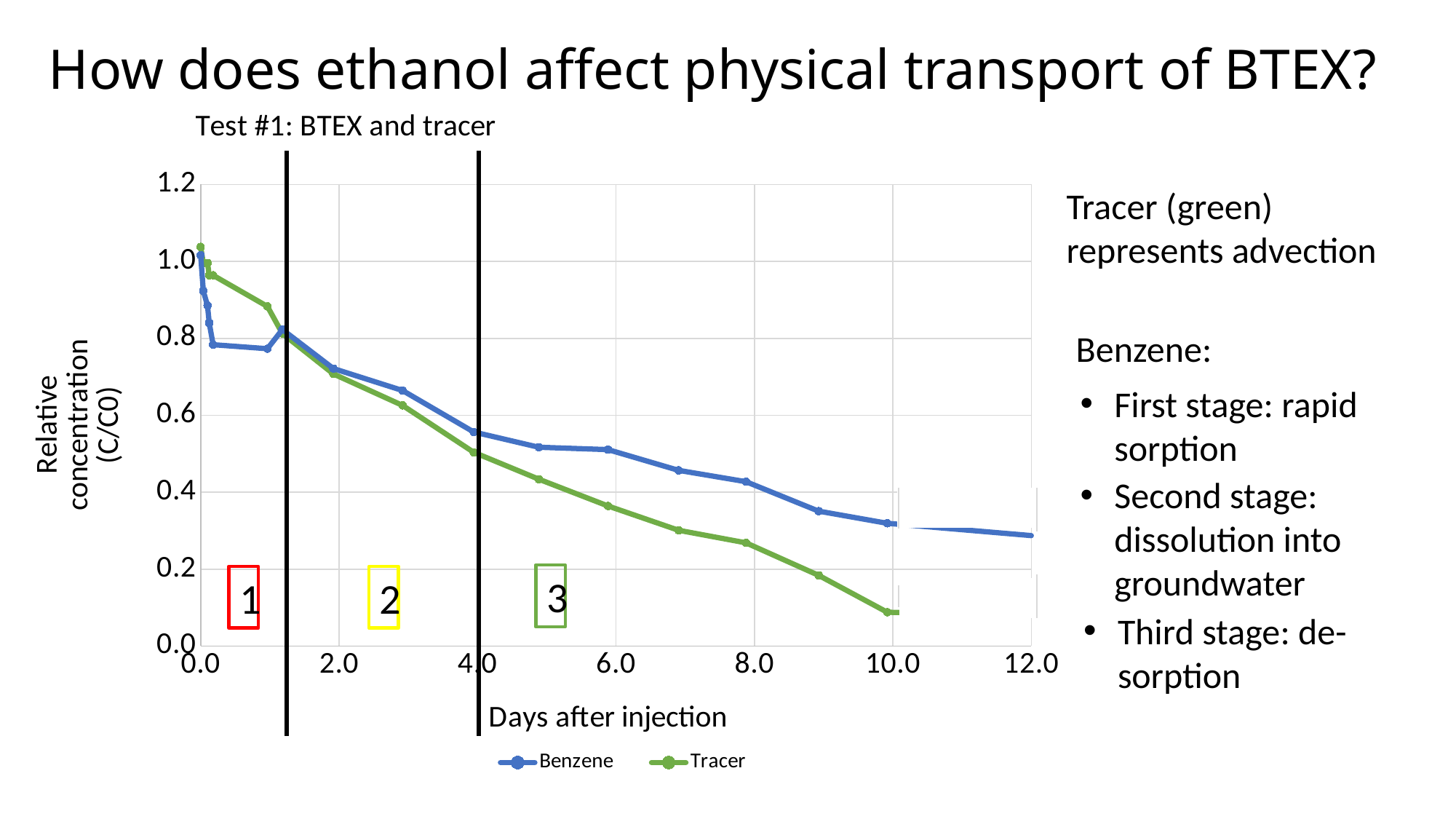
Is the Benzene value at 6.0 days greater or less than 0.4? greater How many series does the legend list? 2 What kind of chart is shown on the slide? line chart Do the Benzene values rise or fall overall from day 0 to day 12? fall What is the label of the x axis? Days after injection Is the Benzene value at 10.0 days greater or less than 0.2? greater At 8.0 days, which series has the lower value, Benzene or Tracer? Tracer Is the Tracer value at 8.0 days greater or less than 0.4? less At 10.0 days, which series has the higher value, Benzene or Tracer? Benzene What is the title of the chart? Test #1: BTEX and tracer Do the Tracer values rise or fall as days after injection increase? fall